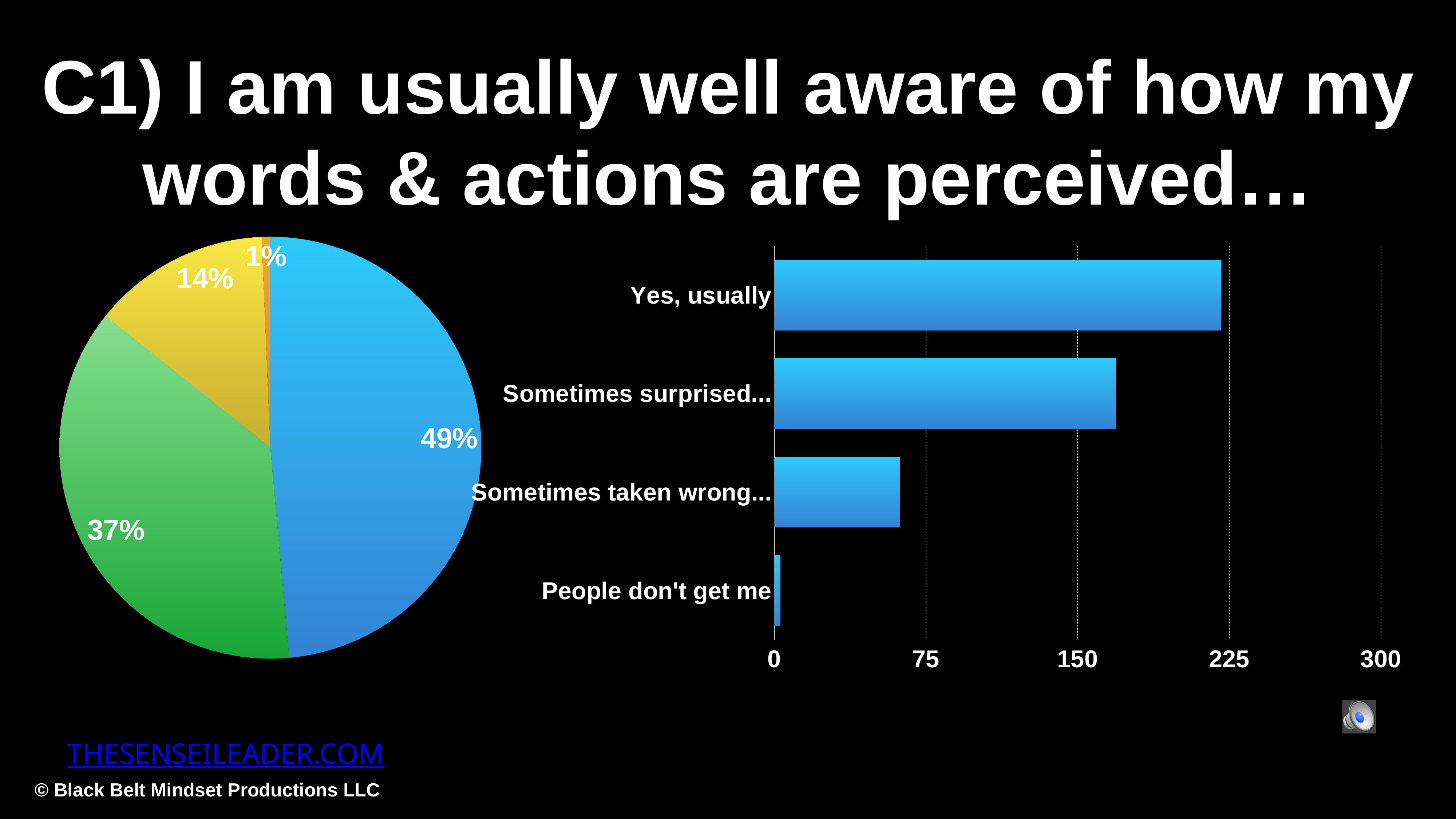
On the pie chart on the left, what share does the yellow slice represent? 14% On the bar chart on the right, which is larger: Sometimes surprised... or Sometimes taken wrong...? Sometimes surprised... On the pie chart on the left, what is the difference between the largest slice (49%) and the second-largest slice (37%)? 12% On the bar chart on the right, is the value for Sometimes taken wrong... greater or less than 75? less On the bar chart on the right, which category has the lowest value? People don't get me On the bar chart on the right, which category has the highest value? Yes, usually On the pie chart on the left, what is the smallest slice's share? 1% On the pie chart on the left, how many slices are there? 4 On the bar chart on the right, how many categories are shown? 4 On the pie chart on the left, what is the largest slice's share? 49% What kind of chart is on the right side of the slide? bar chart On the bar chart on the right, is the value for Sometimes surprised... greater or less than 150? greater